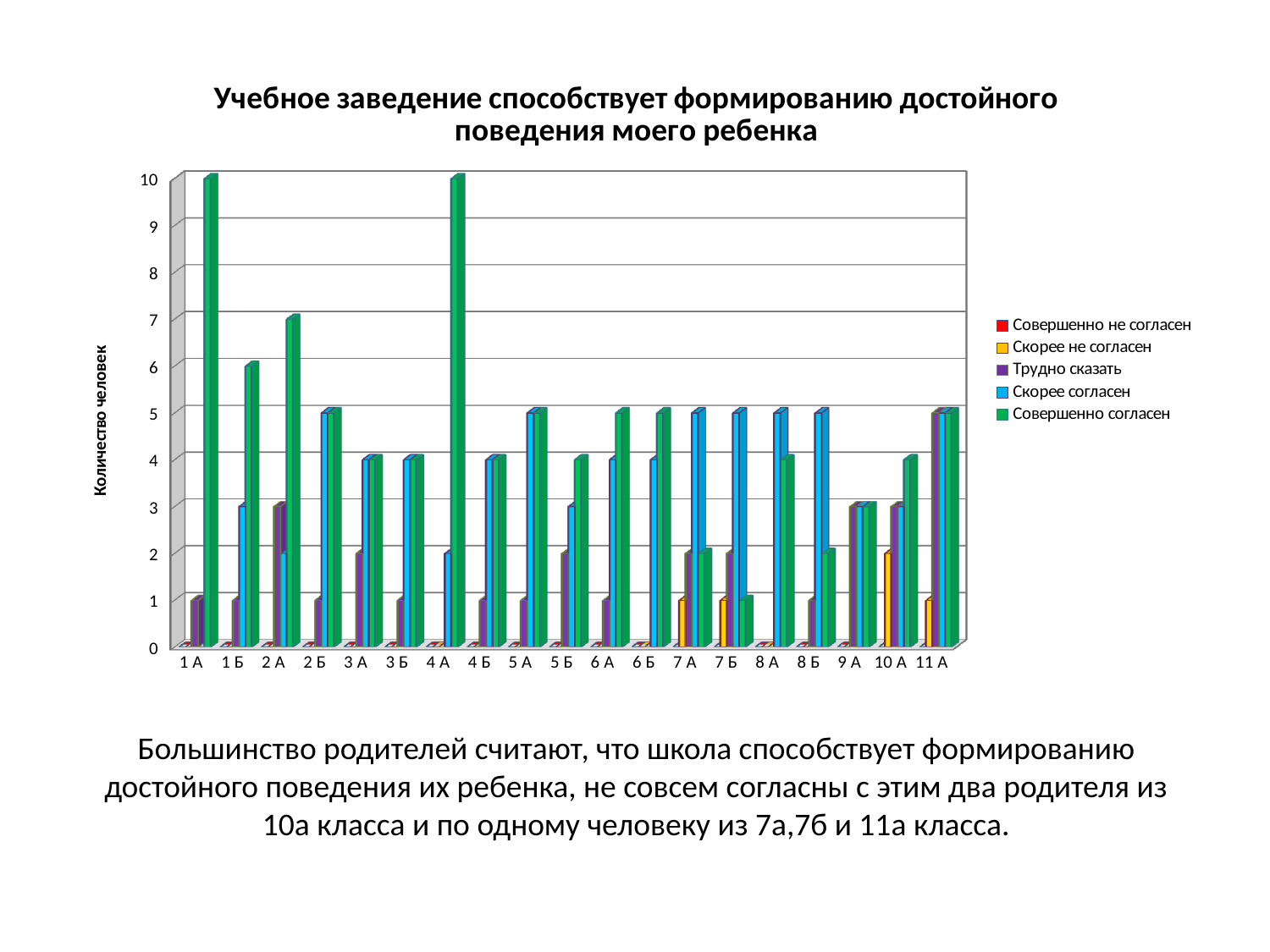
How many series does the legend list? 5 Is the value of "Совершенно согласен" for class 1 Б greater or less than 5? greater What is the value of "Совершенно согласен" for class 4 А? 10 What is the difference between the "Совершенно согласен" values for class 1 А and class 2 А? 3 What is the label of the vertical axis? Количество человек What kind of chart is shown on the slide? bar chart How many classes (categories) are shown on the x axis? 19 Is the value of "Совершенно согласен" for class 7 Б greater or less than 3? less Which class has the highest value for "Скорее не согласен"? 10 А What is the value of "Совершенно согласен" for class 1 А? 10 What is the value of "Совершенно согласен" for class 2 А? 7 Which is larger: "Совершенно согласен" for class 2 А or for class 1 Б? 2 А